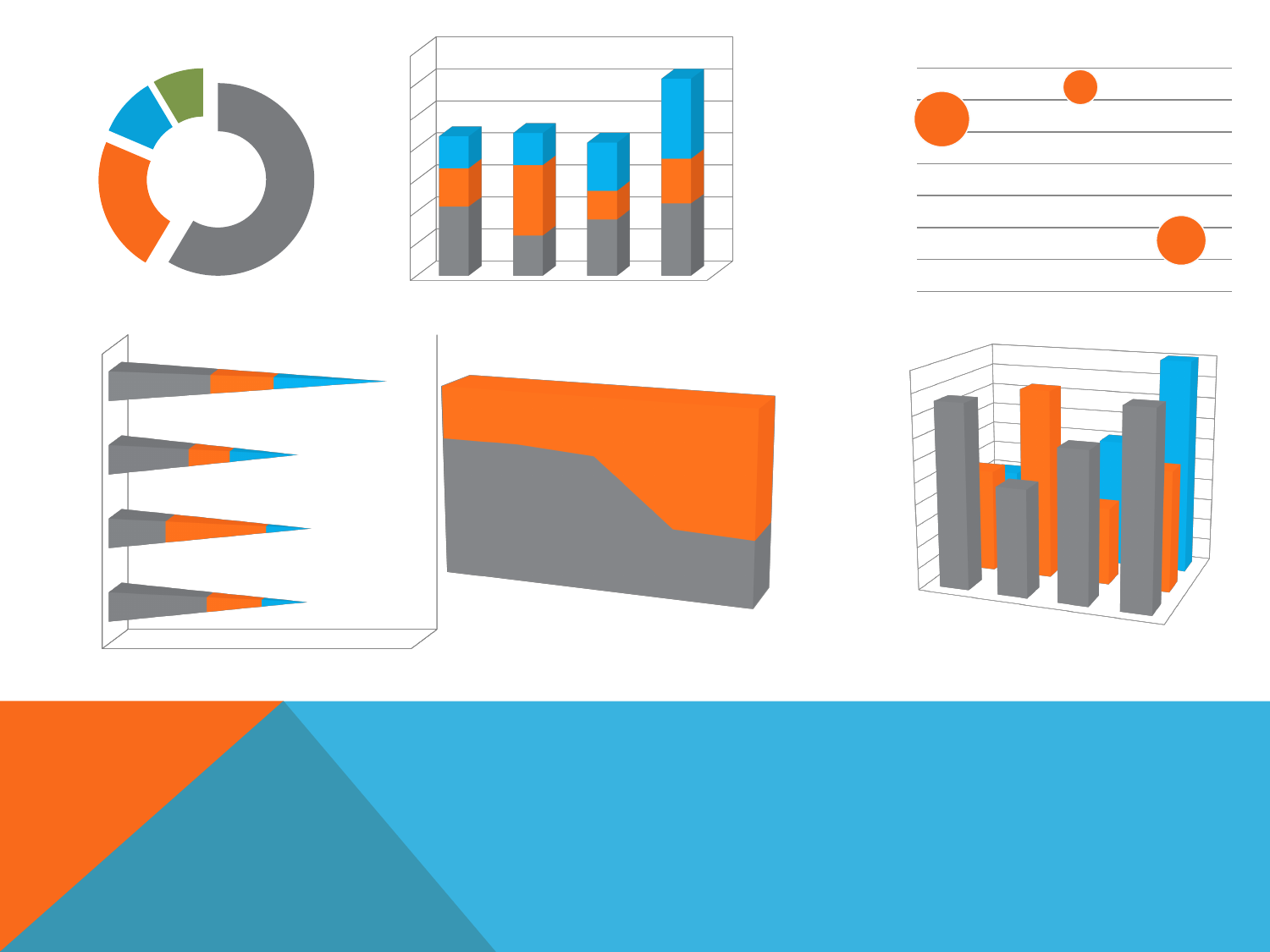
How many colour series are stacked in each bar of the top-middle chart? 3 What kind of chart is the top-left chart on the slide? doughnut chart How many bubbles are plotted in the top-right bubble chart? 3 How many bars does the top-middle stacked bar chart have? 4 How many slices does the top-left doughnut chart have? 4 In the top-middle stacked bar chart, which bar is the tallest, counting from the left? the fourth bar In the top-left doughnut chart, which colour slice is the largest? gray What kind of chart is the top-right chart on the slide? bubble chart In the top-left doughnut chart, which colour slice is the smallest? green What kind of chart is the top-middle chart on the slide? stacked bar chart